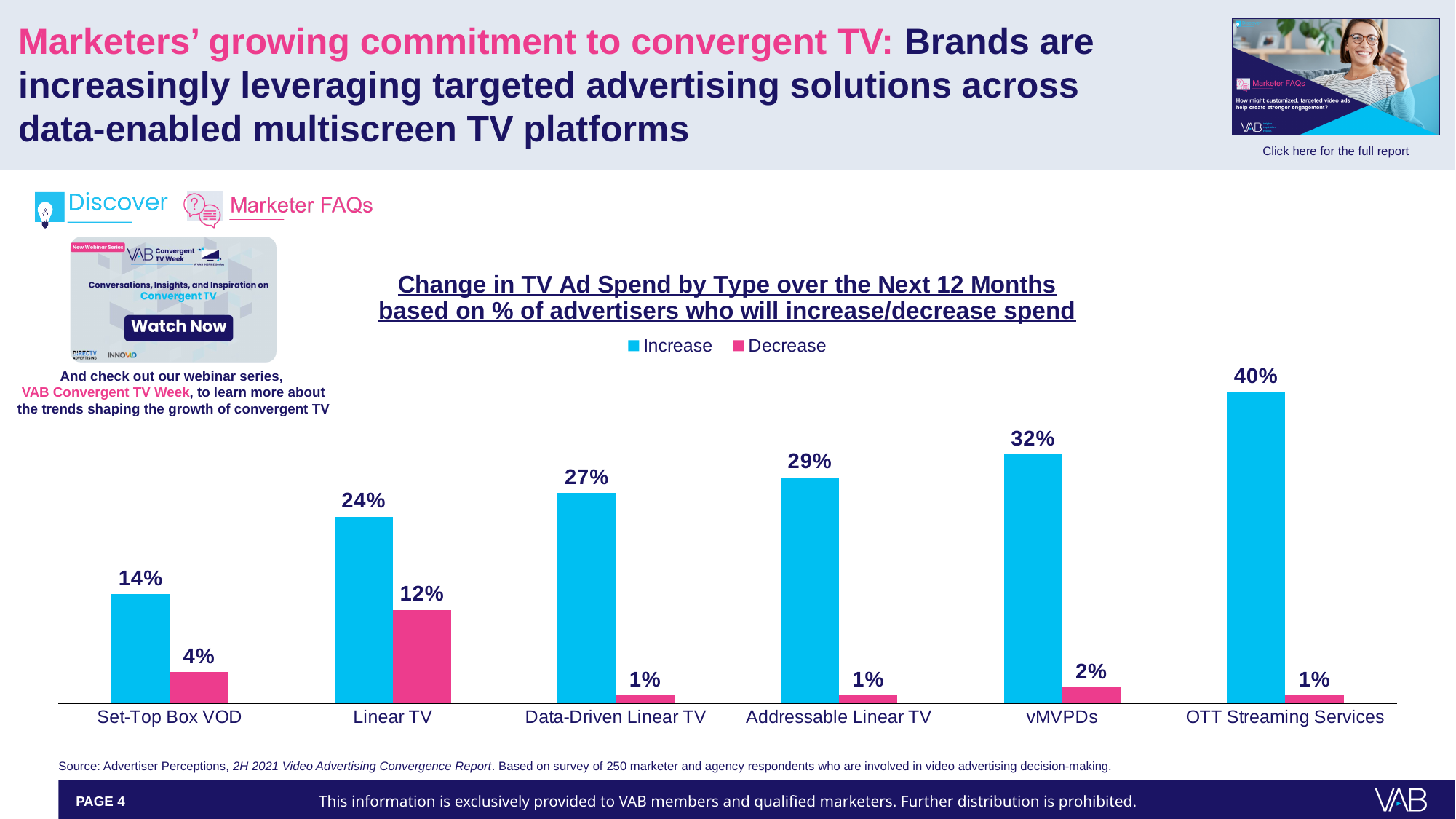
Which category has the highest Decrease value? Linear TV Which category has the lowest Increase value? Set-Top Box VOD What is the Decrease value for Linear TV? 12% What is the difference between the Increase and Decrease values for vMVPDs? 30% What type of chart is shown on the slide? Bar chart How many series does the legend list? 2 Which is larger, the Increase value for Data-Driven Linear TV or for Linear TV? Data-Driven Linear TV What percentage of advertisers will increase spend on OTT Streaming Services? 40% What is the difference between the Increase values for OTT Streaming Services and Set-Top Box VOD? 26% What is the Increase value for Addressable Linear TV? 29% Which category has the highest Increase value? OTT Streaming Services How many categories are shown on the x axis of the chart? 6